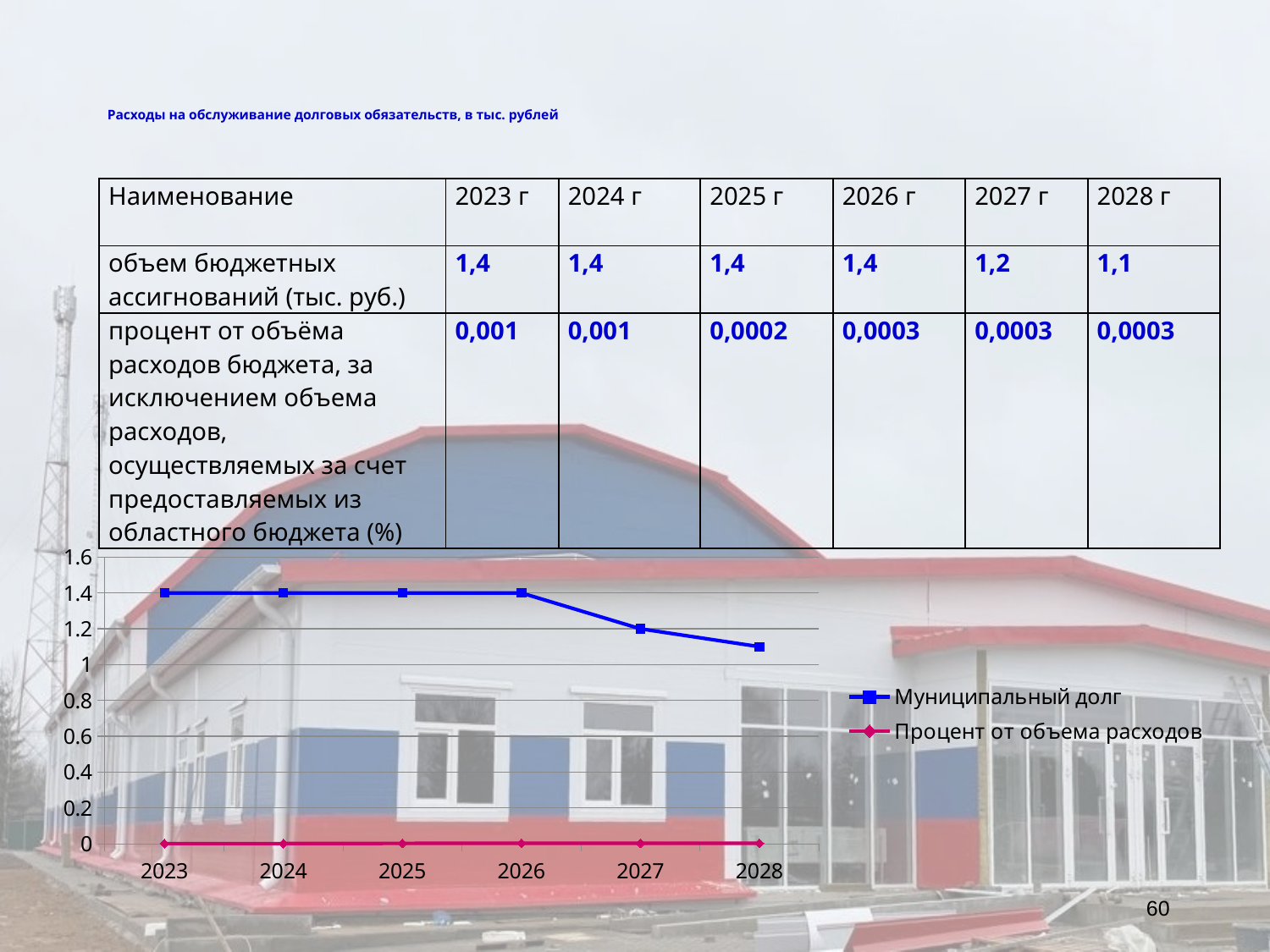
What kind of chart is shown on the slide? line chart In which year is Муниципальный долг lowest? 2028 Is the value of Муниципальный долг in 2028 greater or less than 1.2? less How many series does the chart legend list? 2 Is the value of Процент от объема расходов in 2025 greater or less than 0.2? less What is the value of Муниципальный долг in 2027? 1.2 What is the value of Муниципальный долг in 2023? 1.4 Which is larger for Муниципальный долг: the value in 2026 or in 2027? 2026 Does the Муниципальный долг line rise or fall from 2026 to 2028? fall How many years are plotted along the x axis of the chart? 6 What is the difference between Муниципальный долг in 2026 and in 2027? 0.2 What colour is the Муниципальный долг line in the chart? blue